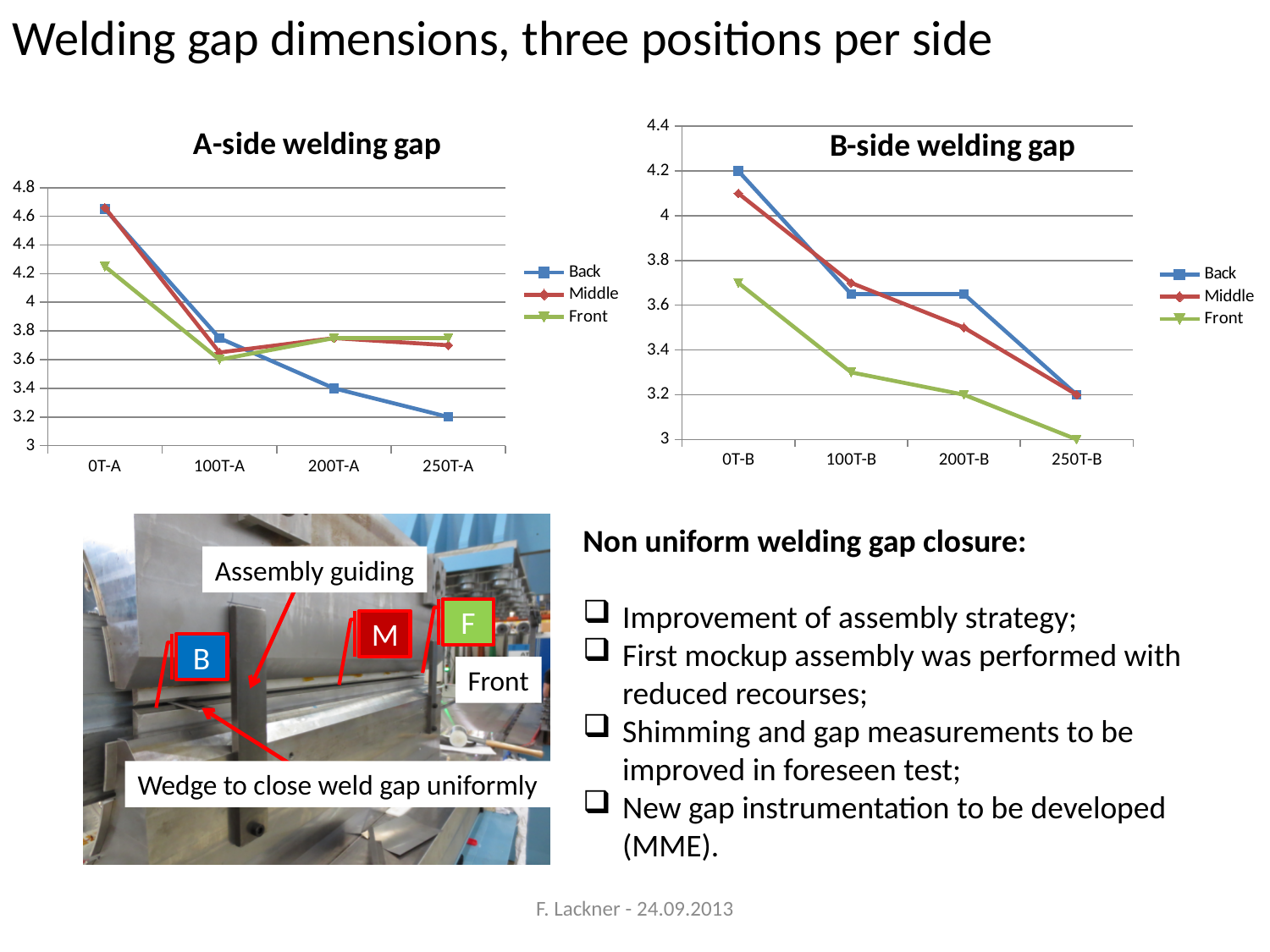
On the A-side welding gap chart, is the value of the Back series at 0T-A greater or less than 4.4? greater On the B-side welding gap chart, what is the value of the Front series at 200T-B? 3.2 On the A-side welding gap chart, what is the value of the Back series at 250T-A? 3.2 On the B-side welding gap chart, at 200T-B, which is larger: the Back value or the Front value? Back On the B-side welding gap chart, which series has the lowest value at 0T-B? Front On the B-side welding gap chart, what is the value of the Back series at 0T-B? 4.2 What kind of chart is the A-side welding gap chart? line chart On the B-side welding gap chart, is the value of the Front series at 100T-B greater or less than 3.4? less How many series does the legend of the A-side welding gap chart list? 3 How many categories are shown on the x axis of the B-side welding gap chart? 4 On the B-side welding gap chart, what is the value of the Front series at 250T-B? 3 On the A-side welding gap chart, what is the value of the Back series at 200T-A? 3.4